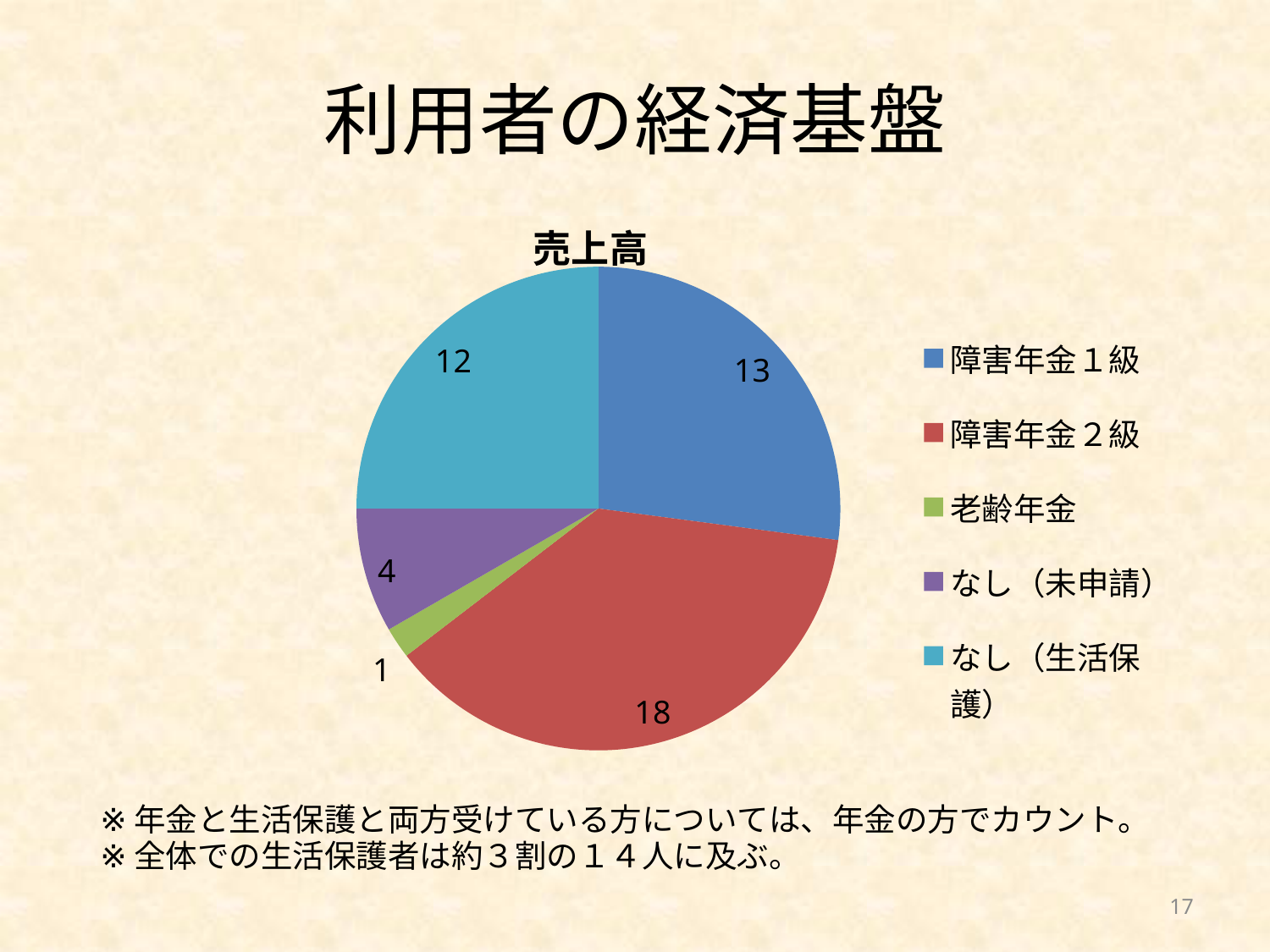
What is the value for なし（未申請）? 4 What type of chart is shown on the slide? pie chart Which category has the largest slice? 障害年金２級 Which category has the smallest slice? 老齢年金 What is the difference between the values for 障害年金２級 and 障害年金１級? 5 What is the value for なし（生活保護）? 12 What is the value for 障害年金１級? 13 How many categories does the legend list? 5 What is the value for 老齢年金? 1 What is the title of the chart? 売上高 What share of the pie does なし（生活保護） represent? 25% What is the value for 障害年金２級? 18